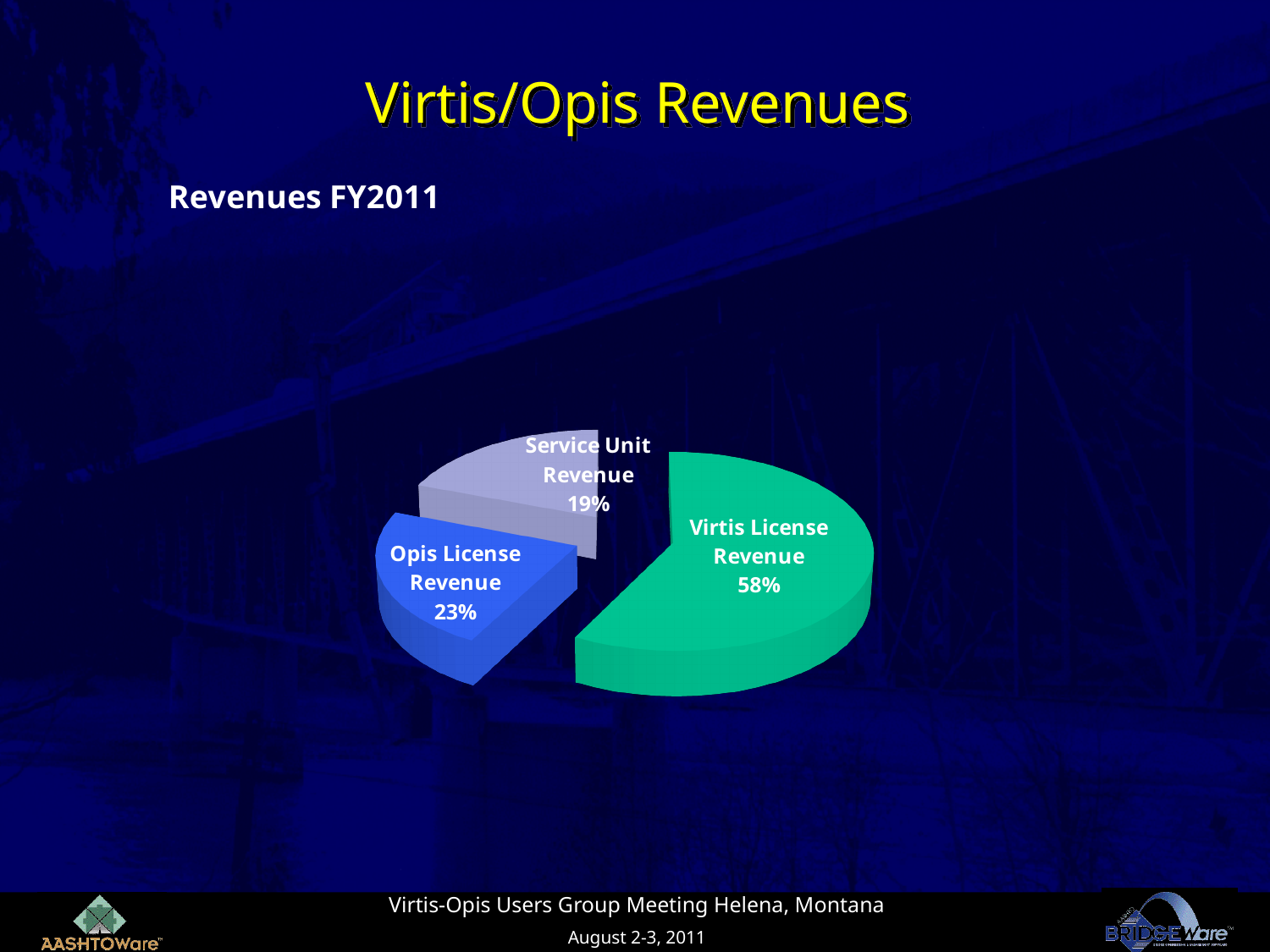
What share of FY2011 revenues comes from Service Unit Revenue? 19% What type of chart is shown on the slide? Pie chart What share of FY2011 revenues comes from Virtis License Revenue? 58% Which revenue category has the largest share of the pie? Virtis License Revenue What is the difference in percentage points between Virtis License Revenue and Opis License Revenue? 35 What share of FY2011 revenues comes from Opis License Revenue? 23% Which revenue category has the smallest share of the pie? Service Unit Revenue What is the title of the chart? Revenues FY2011 What colour is the Virtis License Revenue slice? Green Which is larger: Opis License Revenue or Service Unit Revenue? Opis License Revenue How many slices does the pie chart have? 3 What is the difference in percentage points between Opis License Revenue and Service Unit Revenue? 4